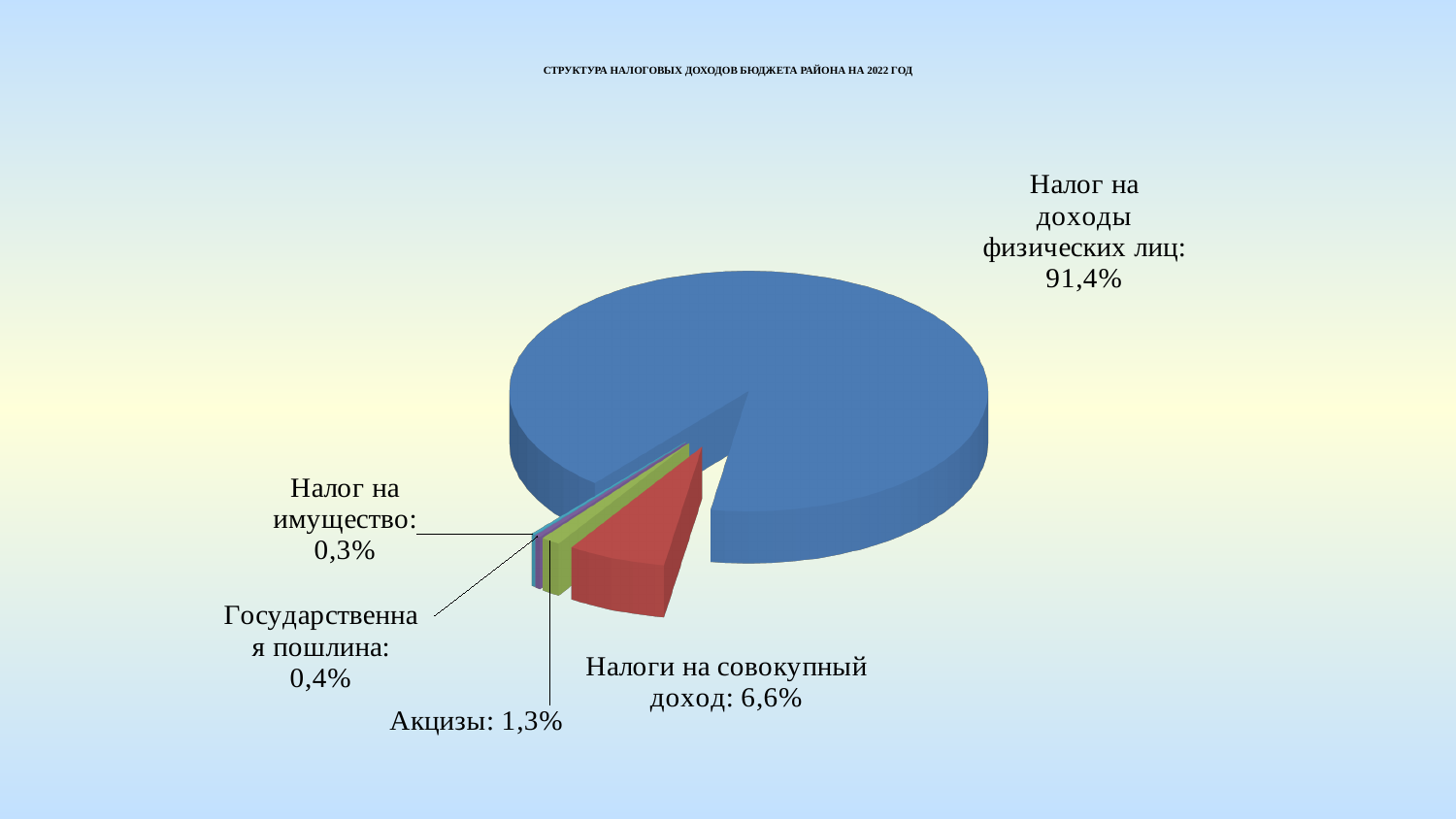
What kind of chart is shown on the slide? Pie chart What is the value shown for "Налог на имущество"? 0,3% What is the title of the chart? СТРУКТУРА НАЛОГОВЫХ ДОХОДОВ БЮДЖЕТА РАЙОНА НА 2022 ГОД What is the value shown for "Государственная пошлина"? 0,4% What is the difference between the shares of "Налоги на совокупный доход" and "Акцизы"? 5,3% Which category has the largest share of the pie? Налог на доходы физических лиц What share of the pie does "Налог на доходы физических лиц" have? 91,4% Which category has the smallest share of the pie? Налог на имущество What is the value shown for "Налоги на совокупный доход"? 6,6% How many slices does the pie chart have? 5 What is the value shown for "Акцизы"? 1,3% Which is larger, the share of "Акцизы" or the share of "Государственная пошлина"? Акцизы